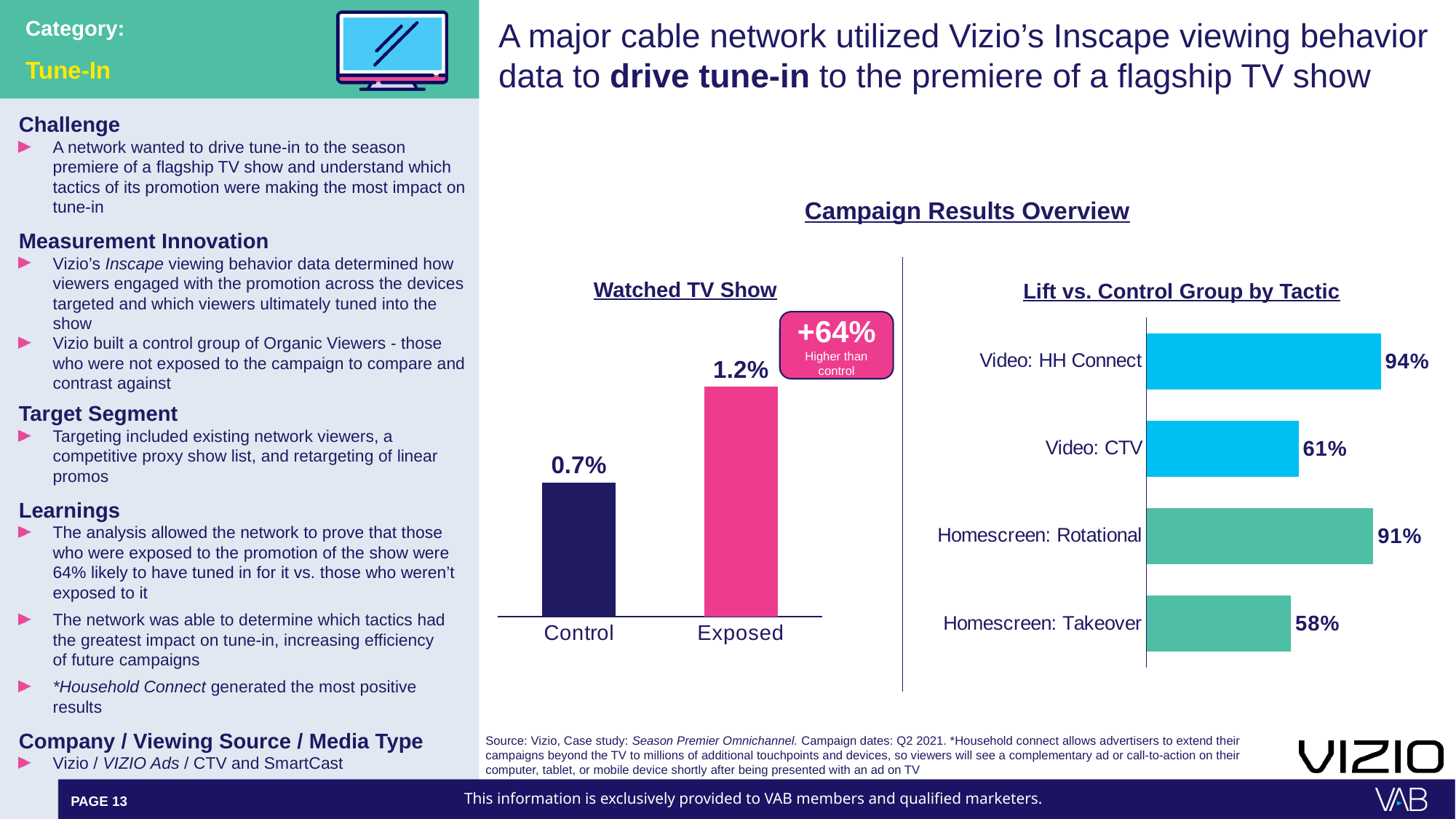
In the 'Lift vs. Control Group by Tactic' chart, which tactic has the highest lift? Video: HH Connect In the 'Watched TV Show' chart, what is the value for Control? 0.7% In the 'Lift vs. Control Group by Tactic' chart, how many tactics are shown? 4 In the 'Lift vs. Control Group by Tactic' chart, what is the value for Homescreen: Rotational? 91% In the 'Lift vs. Control Group by Tactic' chart, what is the value for Video: CTV? 61% In the 'Watched TV Show' chart, what is the difference between the Exposed and Control values? 0.5% In the 'Watched TV Show' chart, which category has the higher value, Control or Exposed? Exposed In the 'Watched TV Show' chart, what is the value for Exposed? 1.2% In the 'Lift vs. Control Group by Tactic' chart, which tactic has the lowest lift? Homescreen: Takeover In the 'Watched TV Show' chart, how many bars are plotted? 2 In the 'Lift vs. Control Group by Tactic' chart, what is the difference between Video: HH Connect and Homescreen: Takeover? 36% What kind of chart is the 'Lift vs. Control Group by Tactic' chart? Bar chart